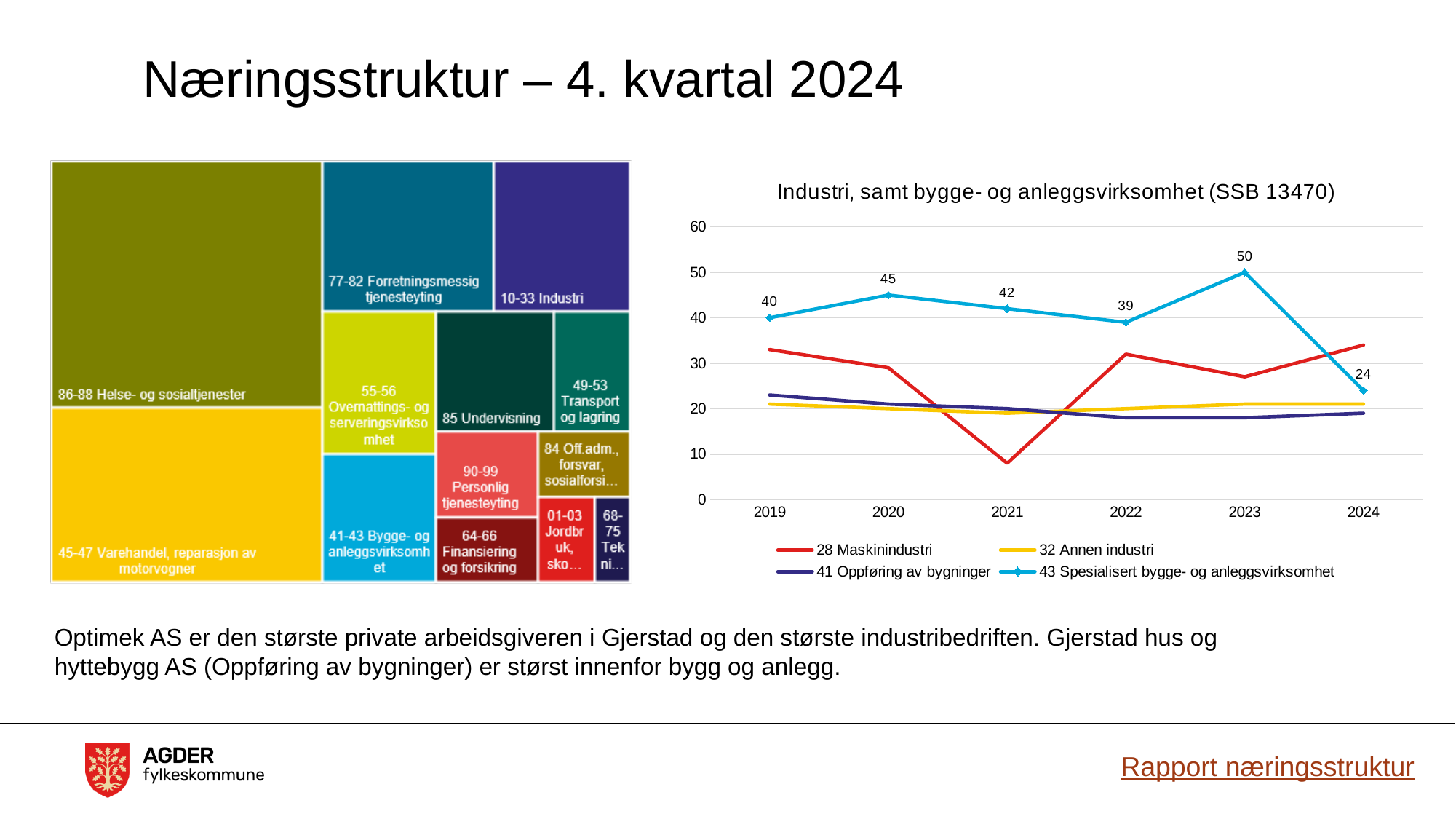
What kind of chart is the chart on the right of the slide? Line chart How many years are shown on the x axis of the line chart on the right? 6 How many series does the legend of the line chart on the right list? 4 On the line chart on the right, what is the value for 43 Spesialisert bygge- og anleggsvirksomhet in 2023? 50 What is the title of the line chart on the right? Industri, samt bygge- og anleggsvirksomhet (SSB 13470) On the line chart on the right, in which year is 43 Spesialisert bygge- og anleggsvirksomhet highest? 2023 On the line chart on the right, what is the value for 43 Spesialisert bygge- og anleggsvirksomhet in 2024? 24 On the line chart on the right, in which year is 43 Spesialisert bygge- og anleggsvirksomhet lowest? 2024 On the line chart on the right, is the value for 28 Maskinindustri in 2024 greater or less than 30? greater On the line chart on the right, by how much did 43 Spesialisert bygge- og anleggsvirksomhet fall from 2023 to 2024? 26 On the line chart on the right, is the value for 28 Maskinindustri in 2021 greater or less than 10? less On the line chart on the right, in 2024 which is larger: 28 Maskinindustri or 43 Spesialisert bygge- og anleggsvirksomhet? 28 Maskinindustri